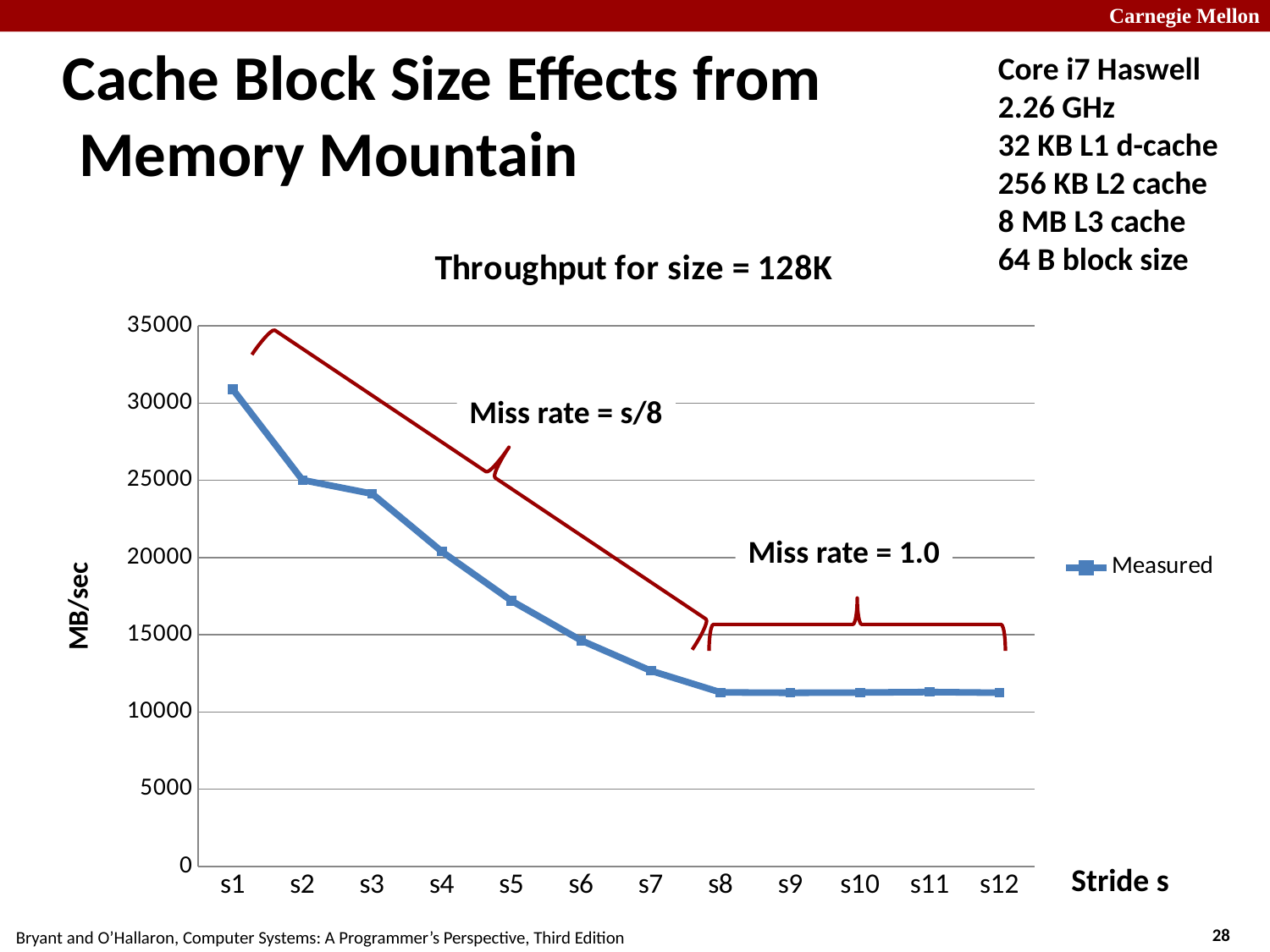
How many stride categories are plotted along the x axis? 12 What is the name of the series shown in the legend? Measured Which has the larger measured throughput, s3 or s6? s3 What kind of chart is shown on the slide? line chart What is the title of the chart? Throughput for size = 128K How many series does the chart's legend list? 1 Is the measured value for s5 greater or less than 15000? greater Is the measured value for s7 greater or less than 15000? less Is the measured value for s1 greater or less than 30000? greater Which stride has the highest measured throughput? s1